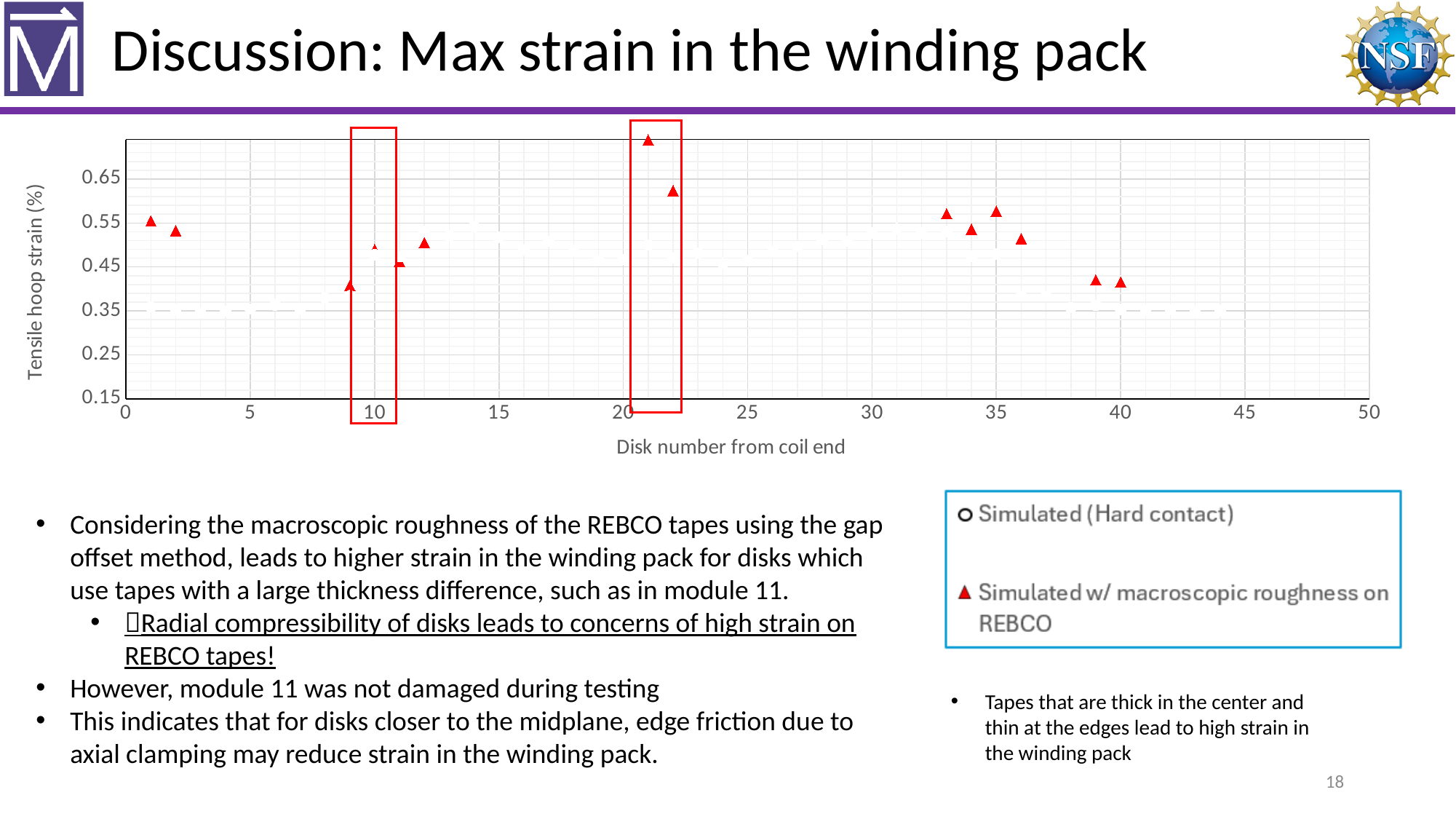
Is the tensile hoop strain for disk 22 greater or less than 0.55? greater Which has the larger tensile hoop strain, disk 22 or disk 39? disk 22 Is the tensile hoop strain for disk 40 greater or less than 0.45? less Which has the larger tensile hoop strain, disk 21 or disk 1? disk 21 What is the title of the y axis of the chart? Tensile hoop strain (%) At which disk number is the highest tensile hoop strain plotted? 21 Is the tensile hoop strain for disk 9 greater or less than 0.45? less What is the title of the x axis of the chart? Disk number from coil end What kind of chart is shown on the slide? scatter chart How many series does the legend list? 2